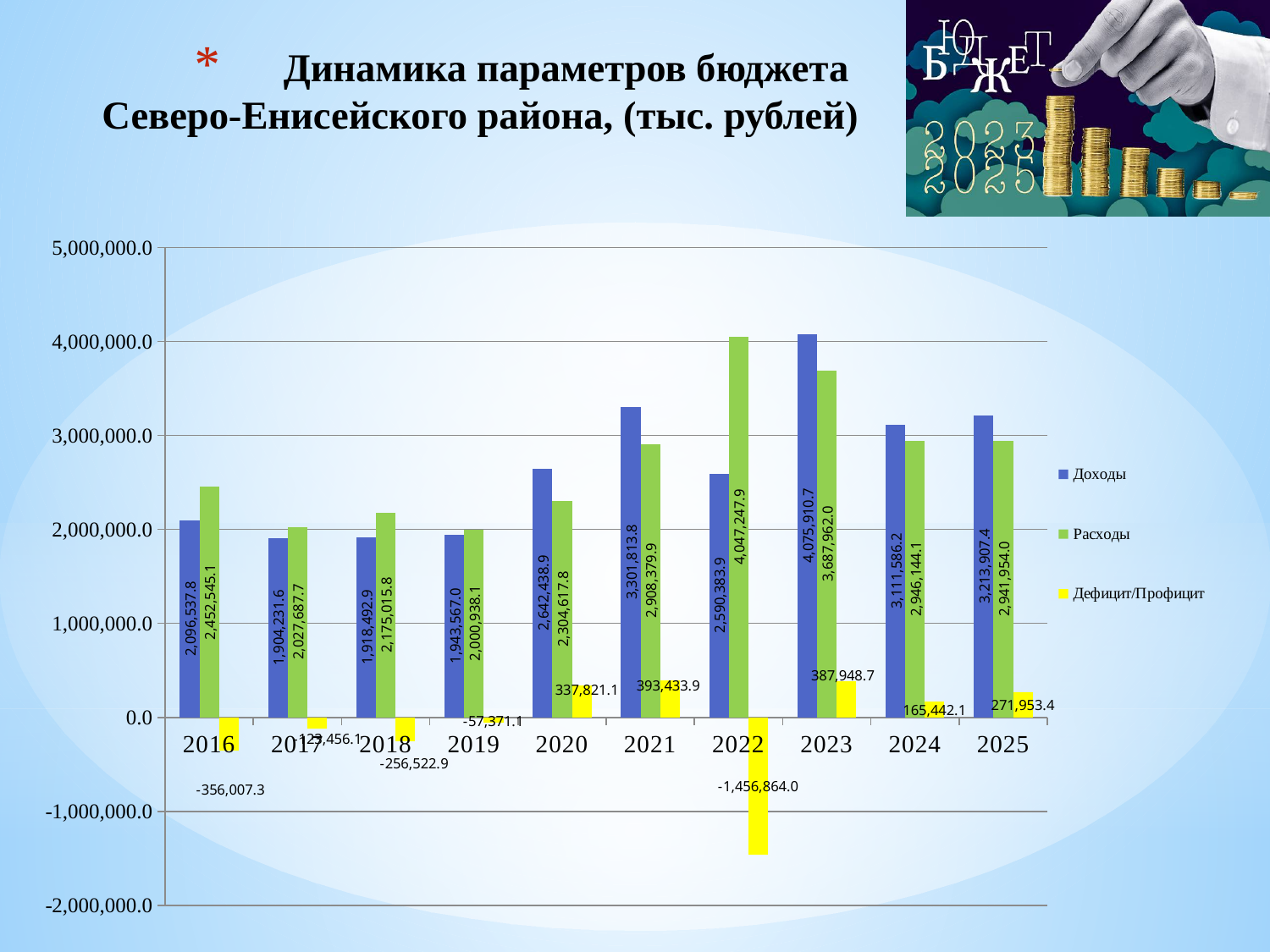
In which year is Доходы the highest? 2023 Which series is shown in yellow in the legend? Дефицит/Профицит What is the value of Дефицит/Профицит for 2016? -356,007.3 What type of chart is shown on the slide? Bar chart How many years are shown on the x axis? 10 What is the value of Доходы for 2023? 4,075,910.7 What is the difference between Расходы and Доходы in 2022? 1,456,864.0 In which year is Дефицит/Профицит the lowest? 2022 Which is larger in 2020, Доходы or Расходы? Доходы How many series does the legend list? 3 Is the value of Расходы for 2021 greater or less than 3,000,000.0? less What is the value of Расходы for 2022? 4,047,247.9